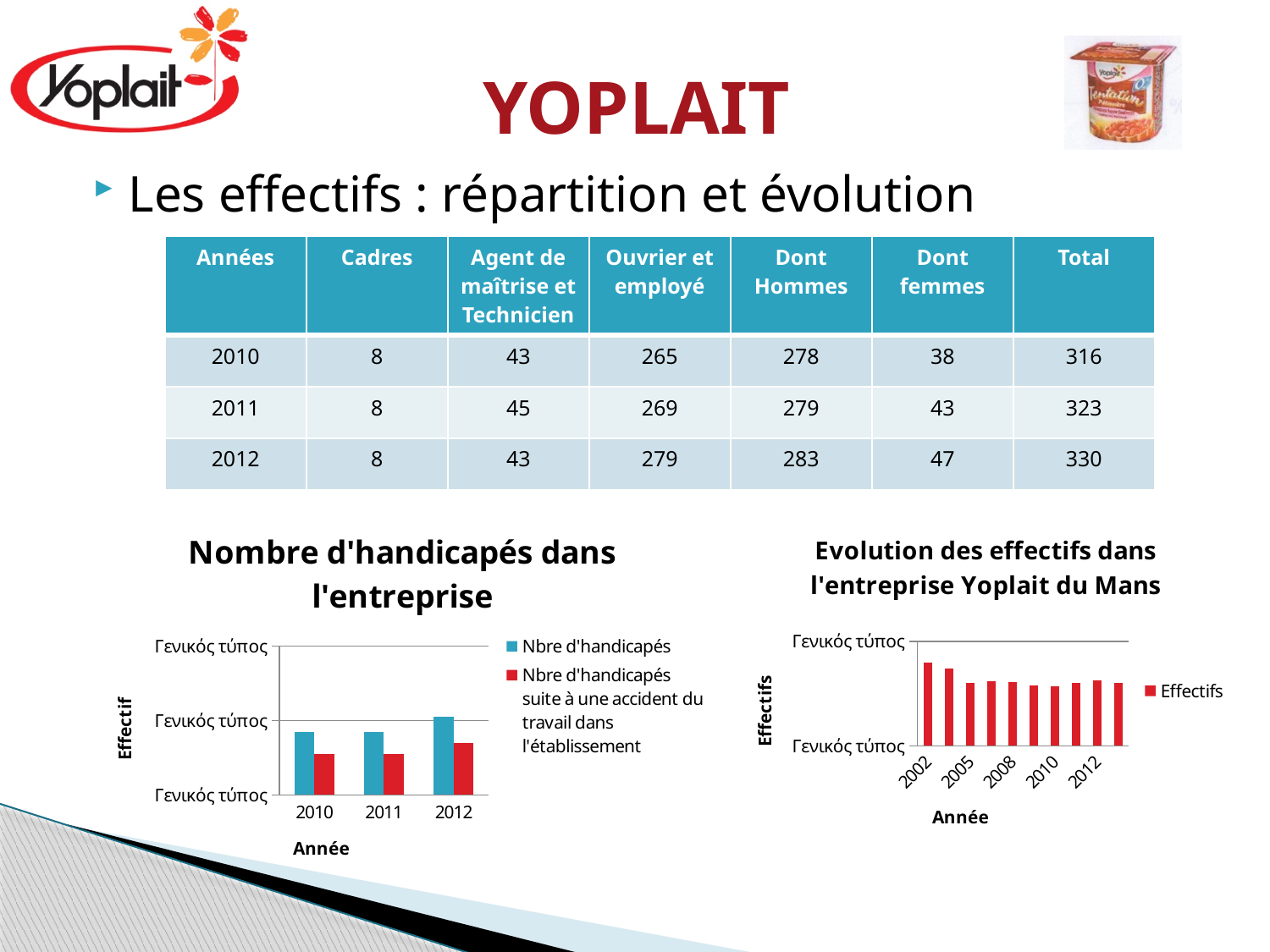
In the 'Evolution des effectifs dans l'entreprise Yoplait du Mans' chart, do the values generally rise or fall from 2002 to 2012? fall In the 'Nombre d'handicapés dans l'entreprise' chart, for 2012, which series is larger: 'Nbre d'handicapés' or 'Nbre d'handicapés suite à une accident du travail dans l'établissement'? Nbre d'handicapés What kind of chart is the 'Nombre d'handicapés dans l'entreprise' chart? bar chart How many bars are plotted in the 'Evolution des effectifs dans l'entreprise Yoplait du Mans' chart? 10 What is the name of the series in the legend of the 'Evolution des effectifs dans l'entreprise Yoplait du Mans' chart? Effectifs How many series does the legend of the 'Evolution des effectifs dans l'entreprise Yoplait du Mans' chart list? 1 How many series does the legend of the 'Nombre d'handicapés dans l'entreprise' chart list? 2 In the 'Evolution des effectifs dans l'entreprise Yoplait du Mans' chart, is the bar for 2002 larger or smaller than the bar for 2012? larger What kind of chart is the 'Evolution des effectifs dans l'entreprise Yoplait du Mans' chart? bar chart How many years are shown on the x axis of the 'Nombre d'handicapés dans l'entreprise' chart? 3 In the 'Evolution des effectifs dans l'entreprise Yoplait du Mans' chart, which year has the highest bar? 2002 In the 'Nombre d'handicapés dans l'entreprise' chart, which year has the highest value for 'Nbre d'handicapés'? 2012